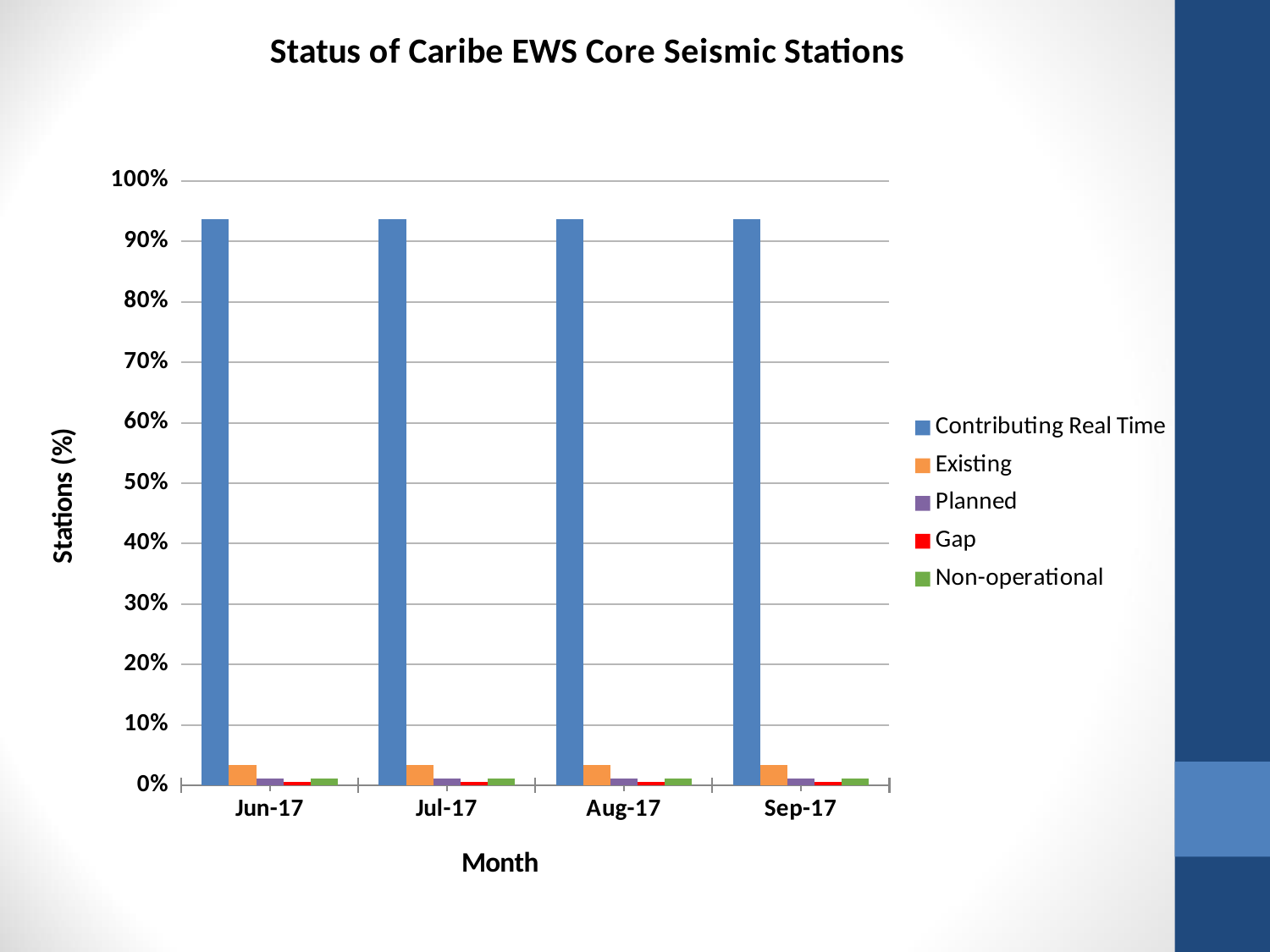
What is the label of the vertical axis? Stations (%) Does the Contributing Real Time value rise, fall, or stay about the same from Jun-17 to Sep-17? stays about the same How many months are shown on the x axis? 4 What type of chart is shown on the slide? bar chart How many series does the legend list? 5 Which series has the highest value in Jun-17? Contributing Real Time Is the value for Existing in Jul-17 greater or less than 10%? less Which series has the lowest value in Sep-17? Gap Is the value for Contributing Real Time in Jun-17 greater or less than 100%? less What is the title of the chart? Status of Caribe EWS Core Seismic Stations Is the value for Contributing Real Time in Aug-17 greater or less than 90%? greater In Sep-17, which is larger: Existing or Planned? Existing